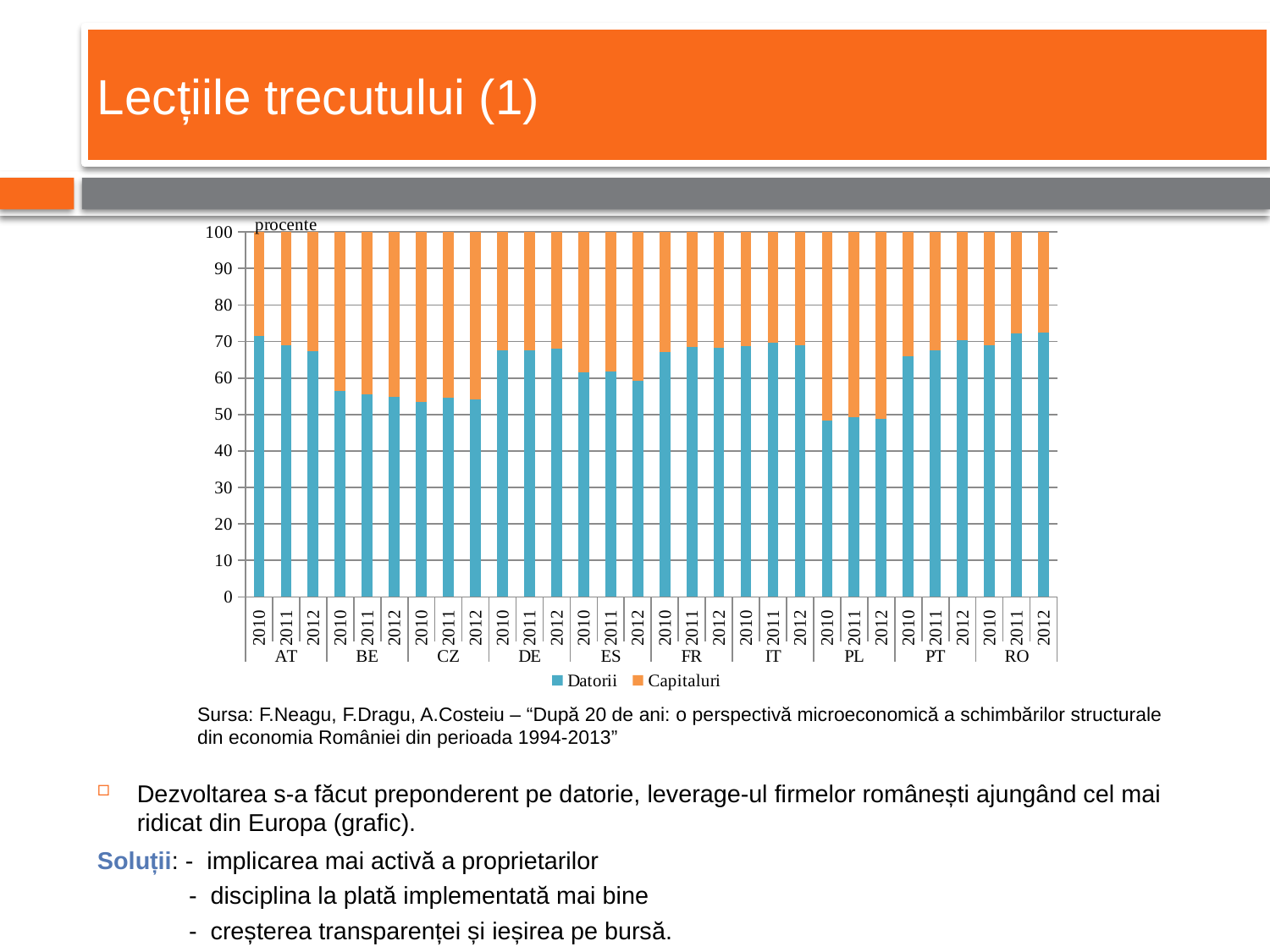
How many series does the legend list? 2 Which country has the lowest Datorii share across the years shown? PL Does the Datorii share for AT rise or fall from 2010 to 2012? fall What are the two series named in the legend? Datorii and Capitaluri What kind of chart is shown on the slide? Stacked bar chart How many countries are shown along the x axis? 10 Is the Datorii value for PL in 2010 greater or less than 50? less How many bars are plotted in the chart in total? 30 What is the total of the stacked bar for RO in 2012? 100 Is the Datorii value for RO in 2012 greater or less than 70? greater Which is larger, the Datorii value for RO in 2012 or for PL in 2012? RO in 2012 Is the Datorii value for CZ in 2011 greater or less than 60? less